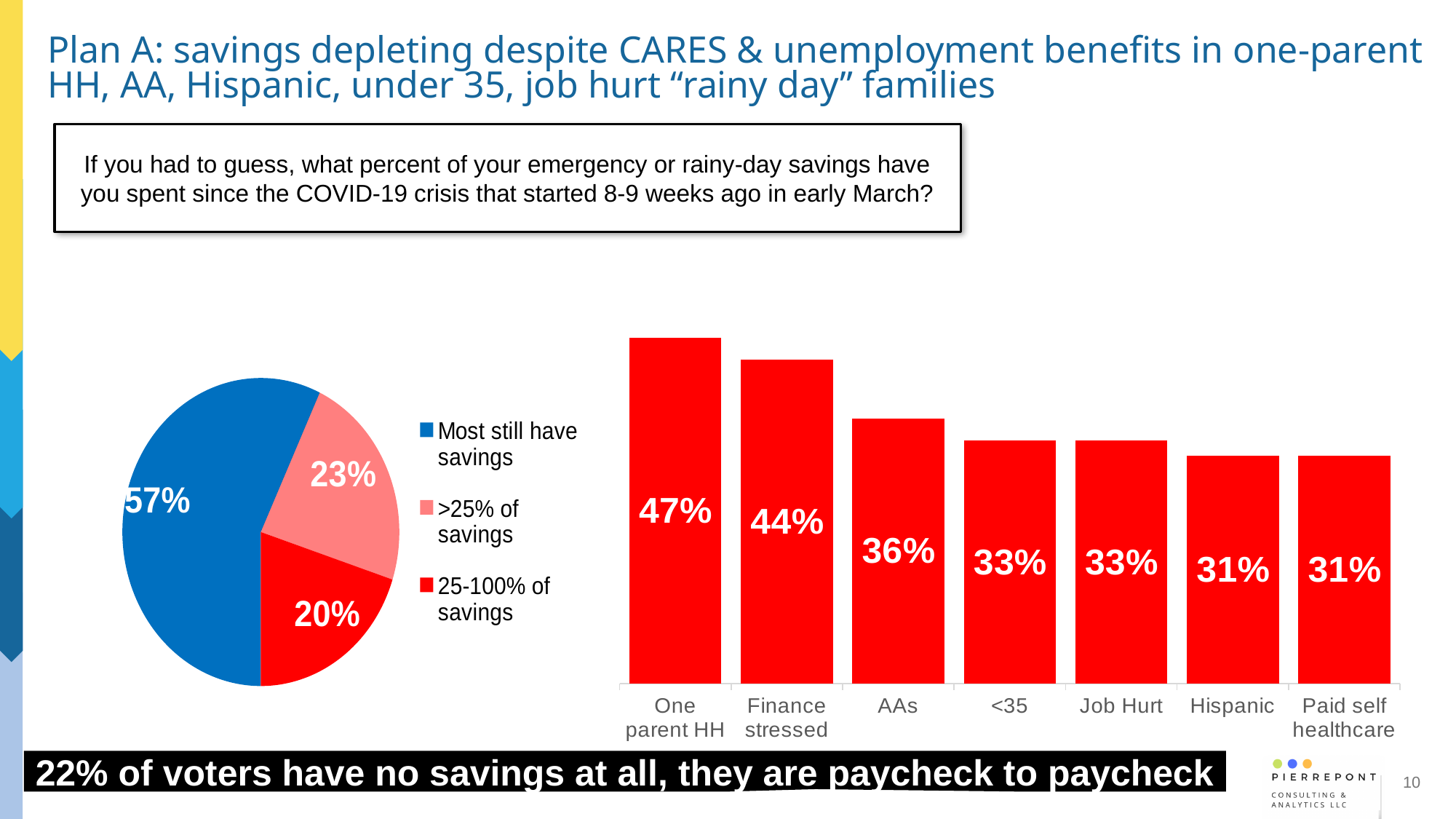
In the bar chart on the right, what is the value for AAs? 36% In the pie chart on the left, how many slices does the legend list? 3 In the bar chart on the right, what is the difference between the values for One parent HH and Hispanic? 16% In the bar chart on the right, how many categories are shown? 7 In the pie chart on the left, what share of the pie is labelled ">25% of savings"? 23% In the bar chart on the right, which is larger, the value for Finance stressed or the value for <35? Finance stressed In the pie chart on the left, what share of the pie is labelled "25-100% of savings"? 20% In the bar chart on the right, what is the value for One parent HH? 47% In the bar chart on the right, do the values rise or fall from left to right? fall In the bar chart on the right, which category has the highest value? One parent HH In the pie chart on the left, what share of the pie is labelled "Most still have savings"? 57% In the pie chart on the left, which slice is the largest? Most still have savings